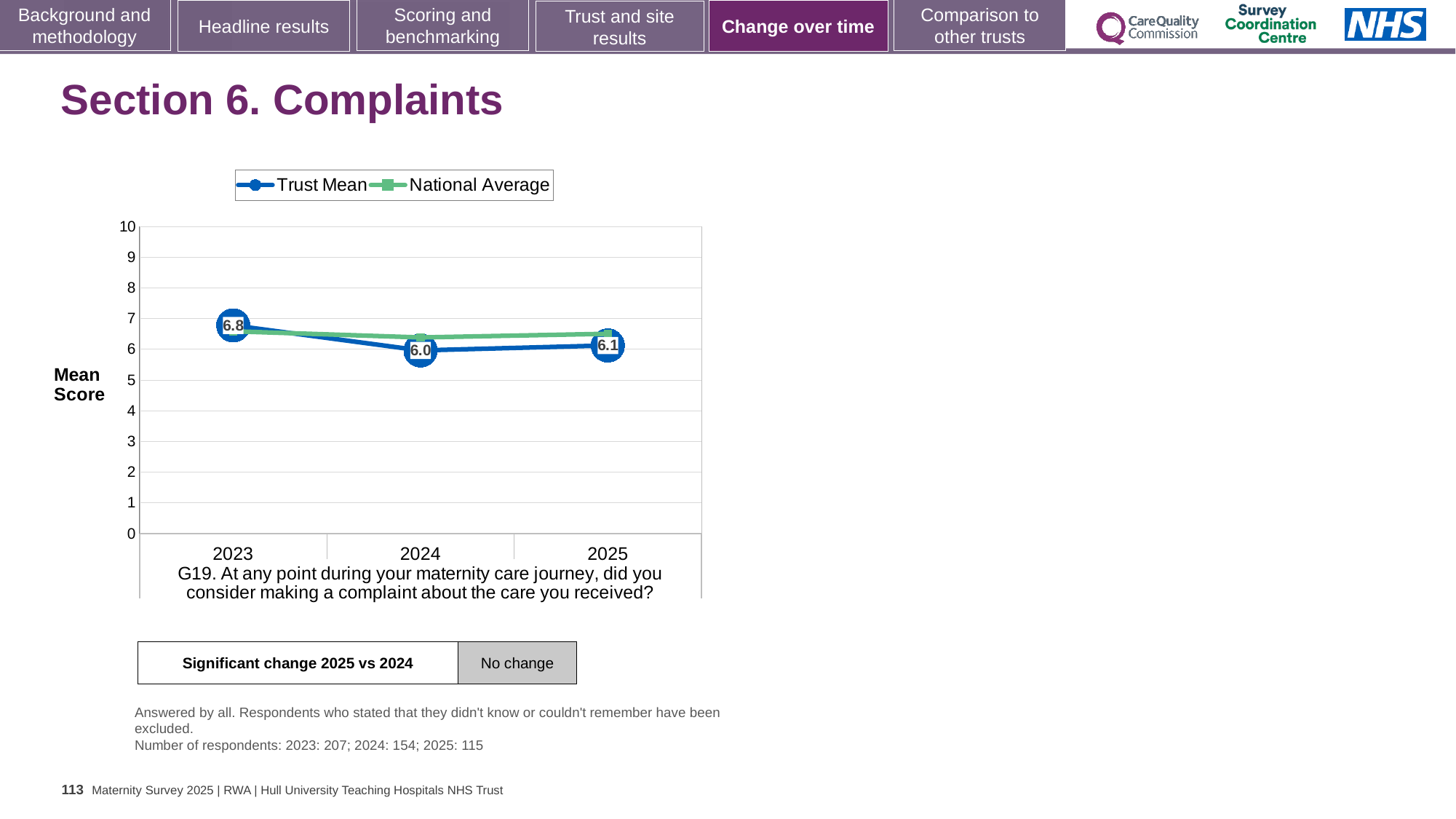
Which is larger, the Trust Mean in 2024 or in 2025? 2025 In which year is the Trust Mean highest? 2023 How many years are plotted on the x axis? 3 What is the Trust Mean value for 2023? 6.8 What is the difference between the Trust Mean in 2023 and in 2024? 0.8 Does the Trust Mean rise or fall from 2023 to 2024? Fall What kind of chart is shown on the slide? Line chart In which year is the Trust Mean lowest? 2024 How many series does the legend list? 2 Is the National Average value for 2023 greater or less than 6? greater What is the Trust Mean value for 2024? 6.0 What is the Trust Mean value for 2025? 6.1